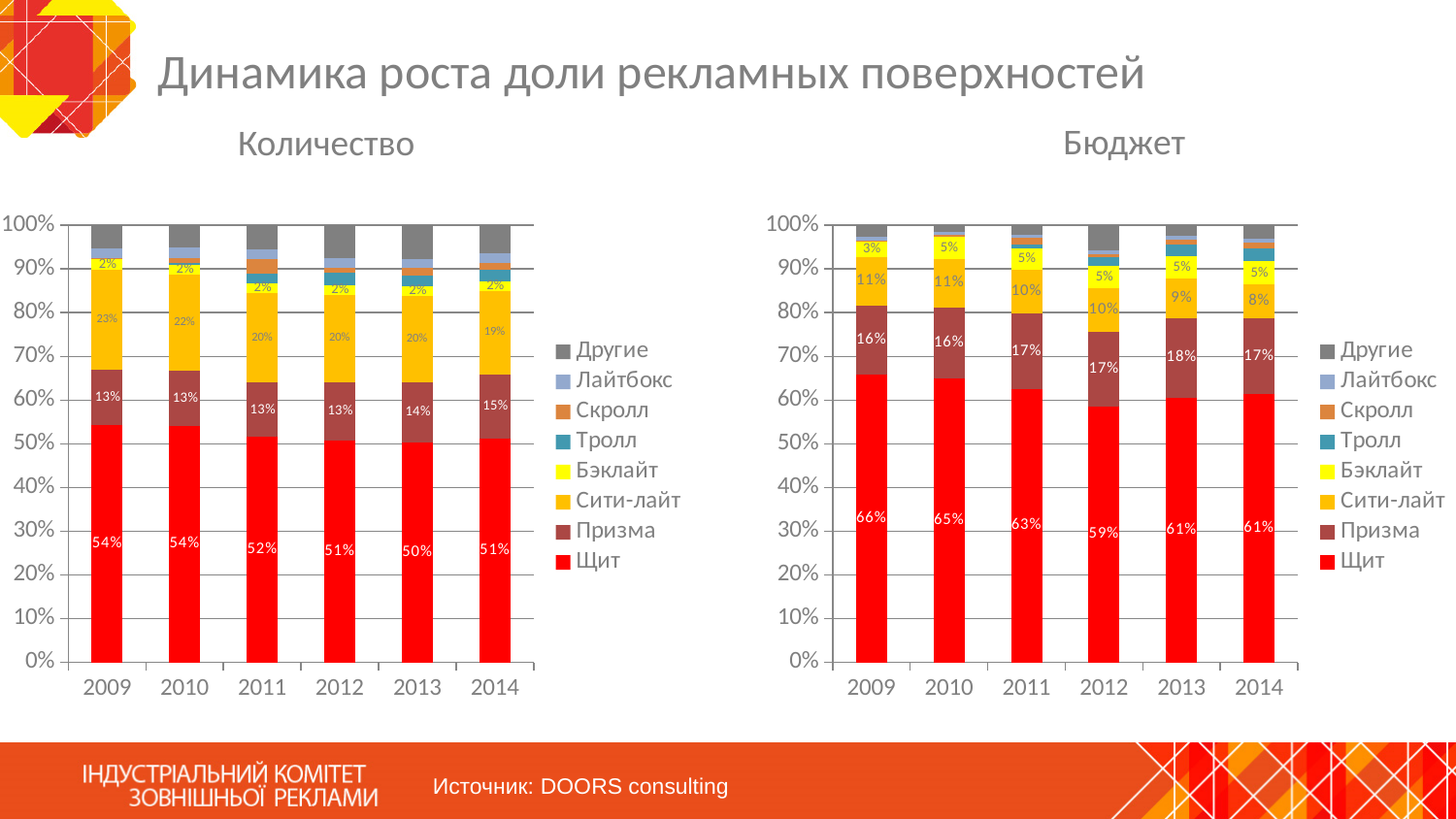
In the Бюджет chart, what is the value for Щит in 2012? 59% Which is larger: the Щит value for 2011 in the Количество chart or the Щит value for 2011 in the Бюджет chart? Бюджет (63%) In the Количество chart, what is the value for Сити-лайт in 2014? 19% In the Бюджет chart, what is the value for Призма in 2013? 18% In the Бюджет chart, what is the difference between the Щит values for 2009 and 2012? 7% In the Количество chart, which year has the highest value for Сити-лайт? 2009 In the Бюджет chart, does the Сити-лайт value rise or fall from 2009 to 2014? Fall In the Количество chart, what is the value for Щит in 2009? 54% In the Бюджет chart, which year has the lowest value for Щит? 2012 How many years are shown on the x axis of the Количество chart? 6 What kind of chart is the Количество chart? Stacked bar chart How many series does the legend of the Бюджет chart list? 8